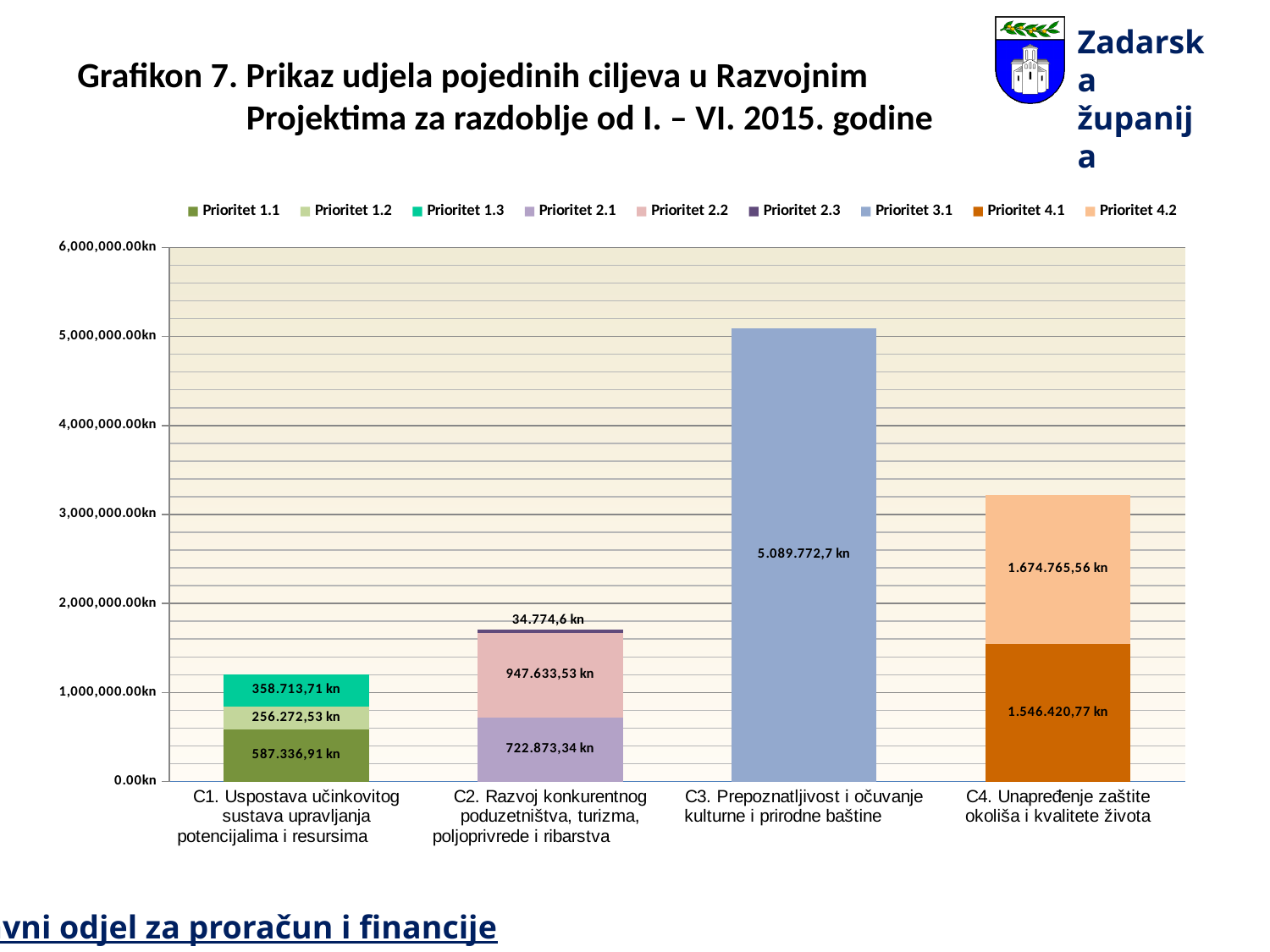
What is the total of the stacked bar for C4. Unapređenje zaštite okoliša i kvalitete života? 3.221.186,33 kn Which category has the shortest stacked bar? C1. Uspostava učinkovitog sustava upravljanja potencijalima i resursima What is the value of Prioritet 1.1 in the C1 bar? 587.336,91 kn What is the value of Prioritet 4.2 in the C4 bar? 1.674.765,56 kn What is the value of Prioritet 3.1 for C3. Prepoznatljivost i očuvanje kulturne i prirodne baštine? 5.089.772,7 kn Is the total value for C3 greater or less than 5,000,000.00kn? greater What is the difference between Prioritet 4.2 and Prioritet 4.1 in the C4 bar? 128.344,79 kn How many categories (ciljevi) are shown on the x axis of the chart? 4 What kind of chart is shown on the slide? Stacked bar chart How many series does the chart legend list? 9 Which category has the tallest stacked bar? C3. Prepoznatljivost i očuvanje kulturne i prirodne baštine What is the value of Prioritet 2.3 in the C2 bar? 34.774,6 kn